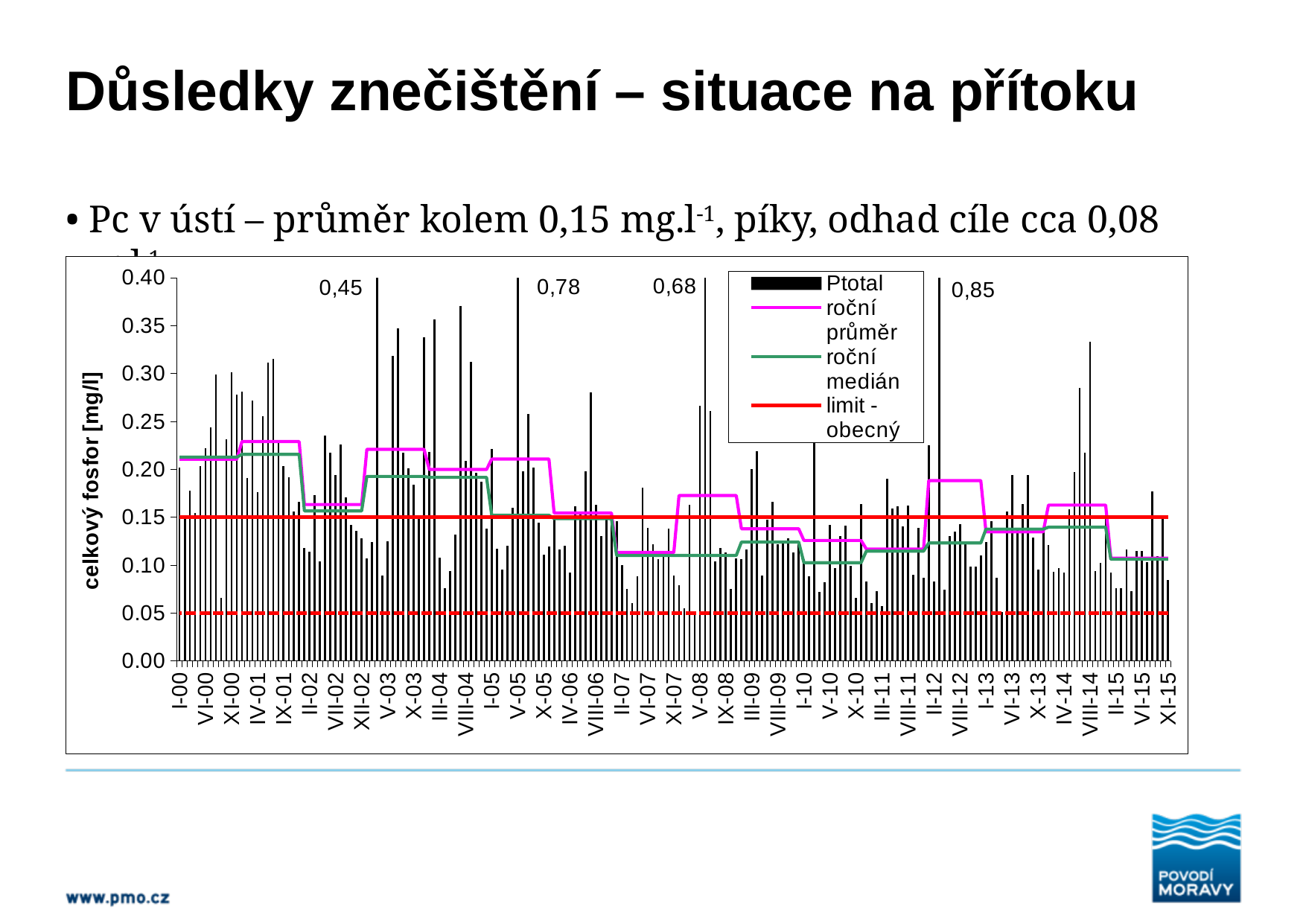
What kind of chart is used to plot the Ptotal series? bar chart Which labelled peak is larger, 0,78 or 0,68? 0,78 Does the 'roční průměr' line rise or fall overall from I-00 to XI-15? fall What is the label of the vertical axis? celkový fosfor [mg/l] What colour is the 'roční průměr' line in the legend? magenta How many peak values are printed as data labels above the chart area? 4 What is the highest peak value printed as a data label on the chart? 0,85 How many series does the chart legend list? 4 Is the 'roční průměr' value at the start of the series (I-00) greater or less than 0.20? greater At what value on the vertical axis is the red 'limit - obecný' line drawn? 0.15 What is the difference between the labelled peaks 0,85 and 0,45? 0,40 What is the lowest of the peak values printed as data labels on the chart? 0,45